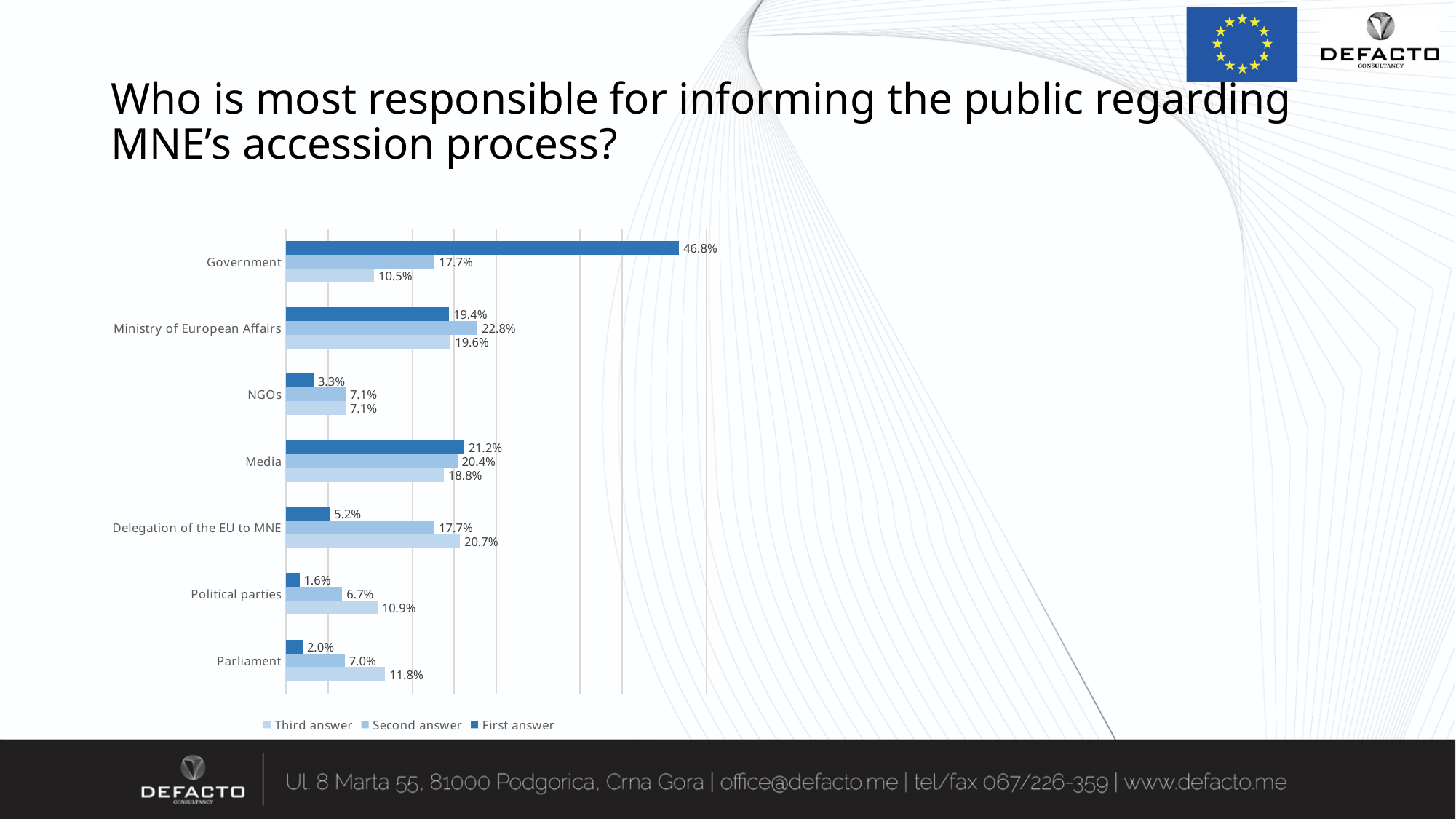
What is the difference between the First answer values for Government and Media? 25.6% What is the Second answer value for the Ministry of European Affairs? 22.8% Which category has the highest First answer value? Government What is the Third answer value for the Delegation of the EU to MNE? 20.7% What percentage of respondents named the Government as their first answer? 46.8% What type of chart is shown on the slide? Bar chart Which category has the lowest First answer value? Political parties How many categories are shown on the chart? 7 How many series does the legend list? 3 What is the First answer value for NGOs? 3.3% What are the three series listed in the legend? Third answer, Second answer, First answer Which is larger for Parliament: the Second answer value or the Third answer value? Third answer